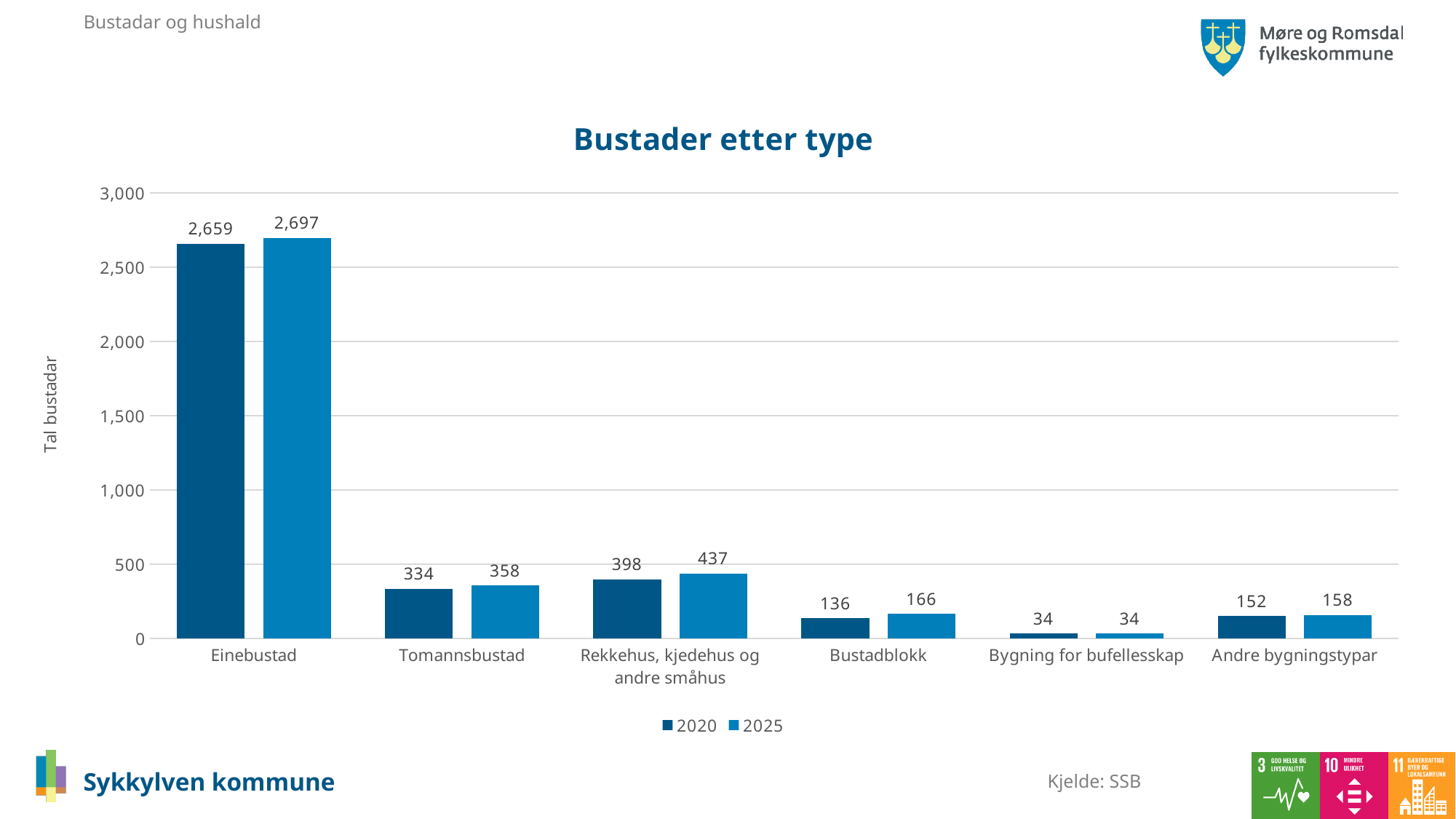
Which category has the lowest value in 2025? Bygning for bufellesskap How many series does the legend list? 2 Which is larger: the 2020 value for Tomannsbustad or the 2020 value for Rekkehus, kjedehus og andre småhus? Rekkehus, kjedehus og andre småhus Which category has the highest value in 2020? Einebustad What is the difference between the 2025 and 2020 values for Einebustad? 38 What kind of chart is shown? Bar chart What is the value for Einebustad in 2025? 2,697 What is the value for Rekkehus, kjedehus og andre småhus in 2025? 437 What is the title of the chart? Bustader etter type How many categories are shown on the x axis? 6 What is the value for Bustadblokk in 2020? 136 What is the difference between the 2025 and 2020 values for Tomannsbustad? 24